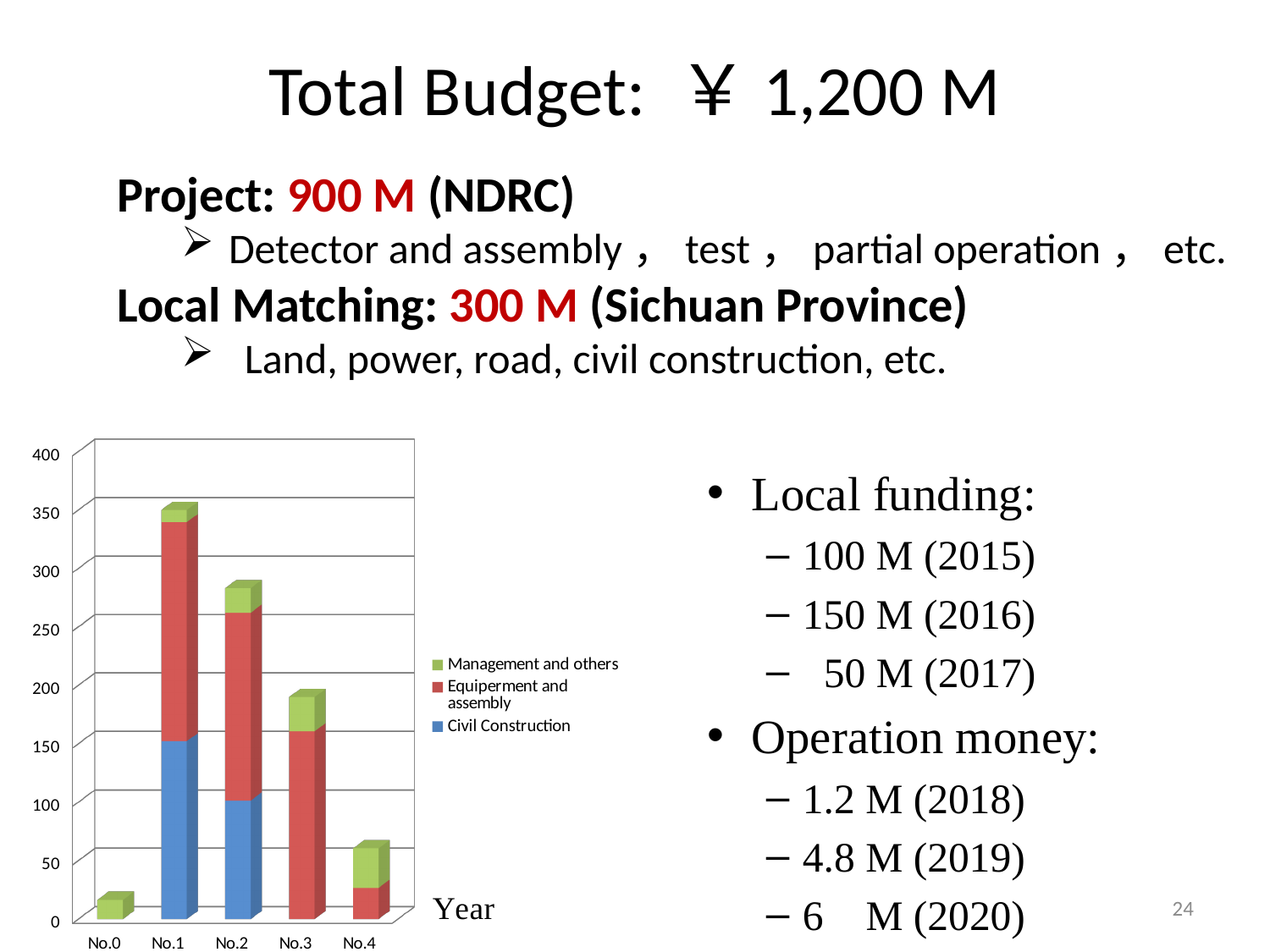
Is the total stacked bar for No.3 greater or less than 150? greater Which category has the shortest stacked bar in the chart? No.0 Do the total stacked bar values rise or fall from No.1 to No.4? fall Which has the larger total stacked bar, No.2 or No.3? No.2 Which series in the legend is shown in blue? Civil Construction Which category has the tallest stacked bar in the chart? No.1 How many categories are shown on the x axis of the chart? 5 Is the total stacked bar for No.0 greater or less than 50? less Is the total stacked bar for No.4 greater or less than 100? less What kind of chart is shown on the slide? stacked bar chart How many series does the chart legend list? 3